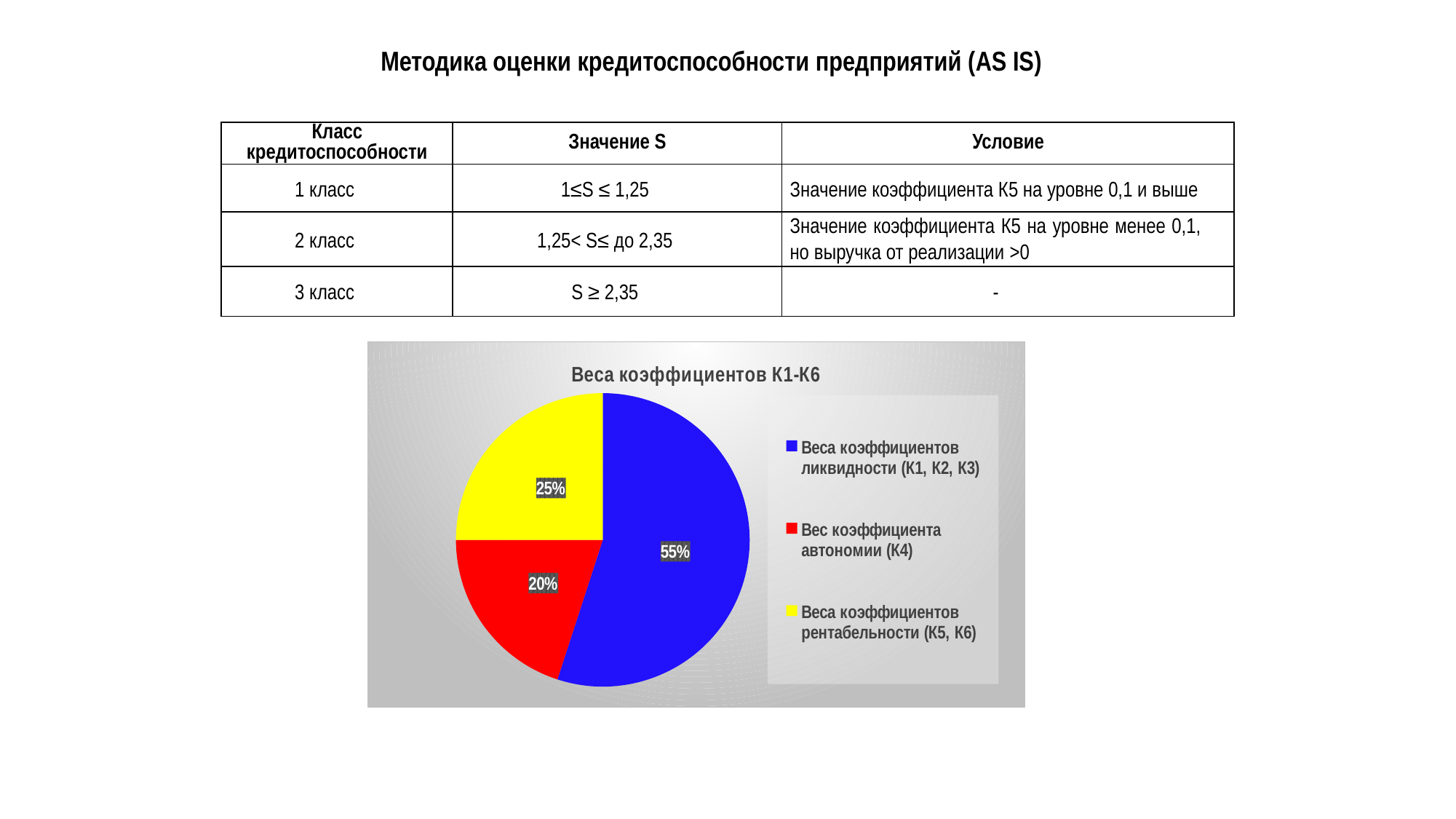
Which category has the smallest slice of the pie? Вес коэффициента автономии (К4) What colour is the slice for 'Вес коэффициента автономии (К4)'? Red What share of the pie is labelled for 'Вес коэффициента автономии (К4)'? 20% What type of chart is shown on the slide? Pie chart What is the title of the chart? Веса коэффициентов К1-К6 What share of the pie is labelled for 'Веса коэффициентов рентабельности (К5, К6)'? 25% How many slices does the pie chart have? 3 Which category has the largest slice of the pie? Веса коэффициентов ликвидности (К1, К2, К3) Which is larger: the share for the autonomy coefficient (К4) or the share for profitability coefficients (К5, К6)? Веса коэффициентов рентабельности (К5, К6) What share of the pie is labelled for 'Веса коэффициентов ликвидности (К1, К2, К3)'? 55% What is the difference between the share for liquidity coefficients (К1, К2, К3) and the share for profitability coefficients (К5, К6)? 30% What is the difference between the share for profitability coefficients (К5, К6) and the share for the autonomy coefficient (К4)? 5%